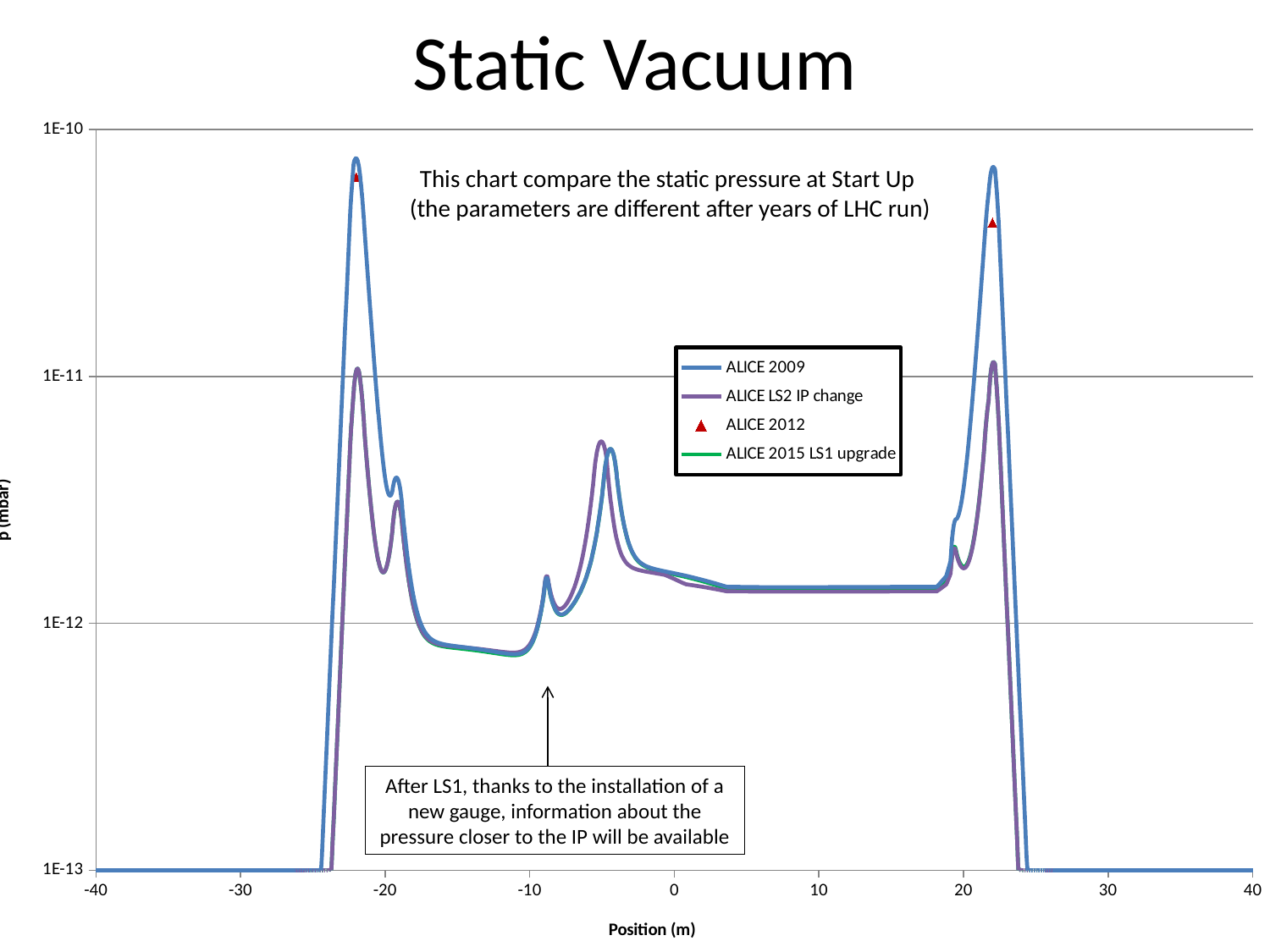
Is the value of ALICE 2009 at position -12 m greater or less than 1E-12? less At the peak near -22 m, which series has the higher pressure, ALICE 2009 or ALICE LS2 IP change? ALICE 2009 Is the peak value of ALICE 2009 near -22 m greater or less than 1E-11? greater What is the title of the chart? Static Vacuum What is the label of the x axis? Position (m) Is the peak value of ALICE 2009 near -5 m greater or less than 1E-11? less How many series does the legend list? 4 How many labelled tick values are shown on the x axis? 9 Which series reaches the highest pressure on the chart? ALICE 2009 Which series is plotted as red triangle markers rather than a line? ALICE 2012 What kind of chart is shown on the slide? line chart